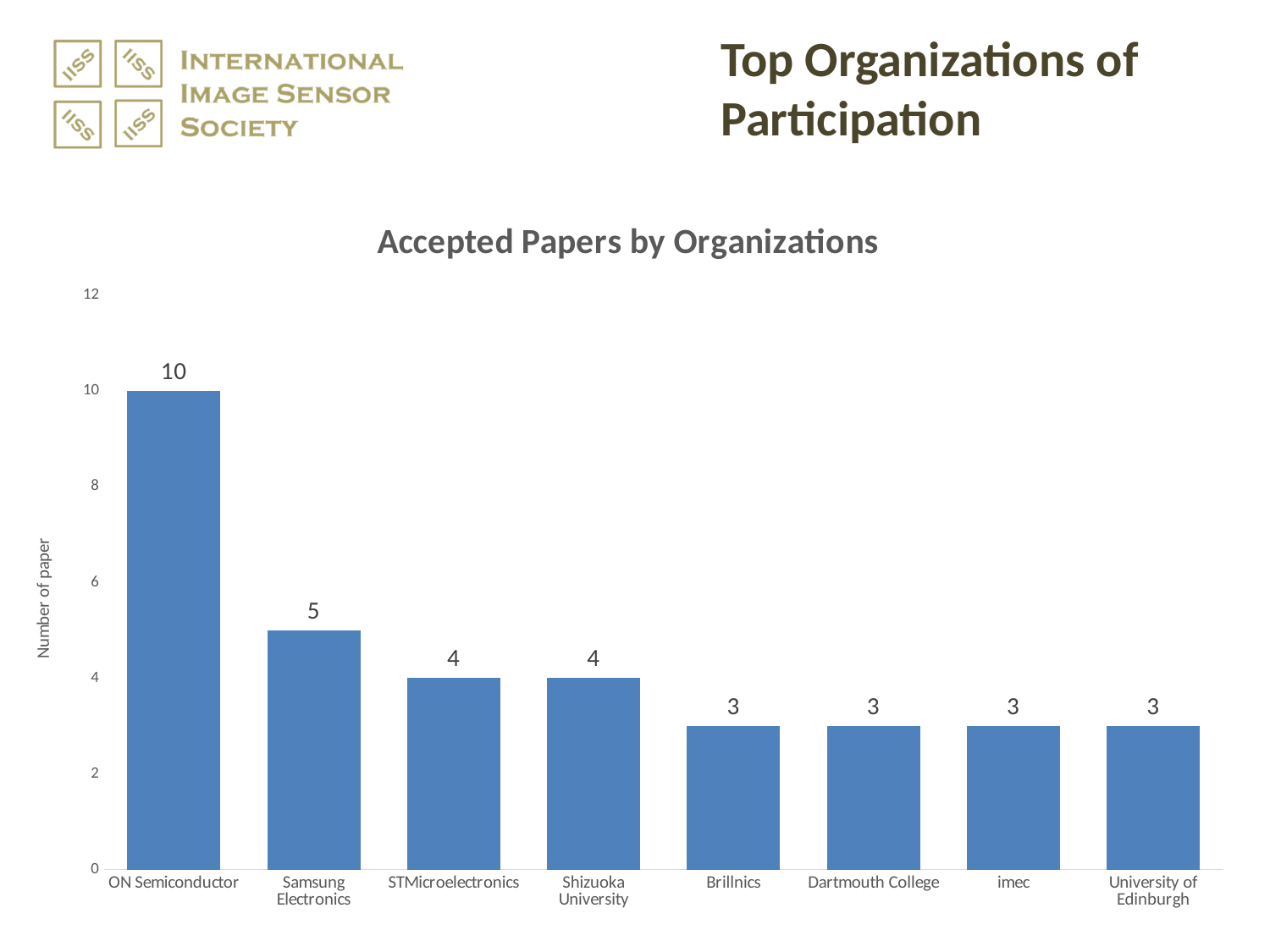
What is the difference in number of papers between ON Semiconductor and Samsung Electronics? 5 How many papers does Shizuoka University have? 4 What is the value for Dartmouth College? 3 How many organizations are shown in the chart? 8 Do the values rise or fall from left to right across the organizations? Fall What type of chart is shown on the slide? Bar chart Which has more accepted papers, Samsung Electronics or STMicroelectronics? Samsung Electronics Which organization has the highest number of accepted papers? ON Semiconductor What is the number of papers for Samsung Electronics? 5 What is the title of the chart? Accepted Papers by Organizations What is the difference between STMicroelectronics and Brillnics in number of papers? 1 How many accepted papers does ON Semiconductor have? 10